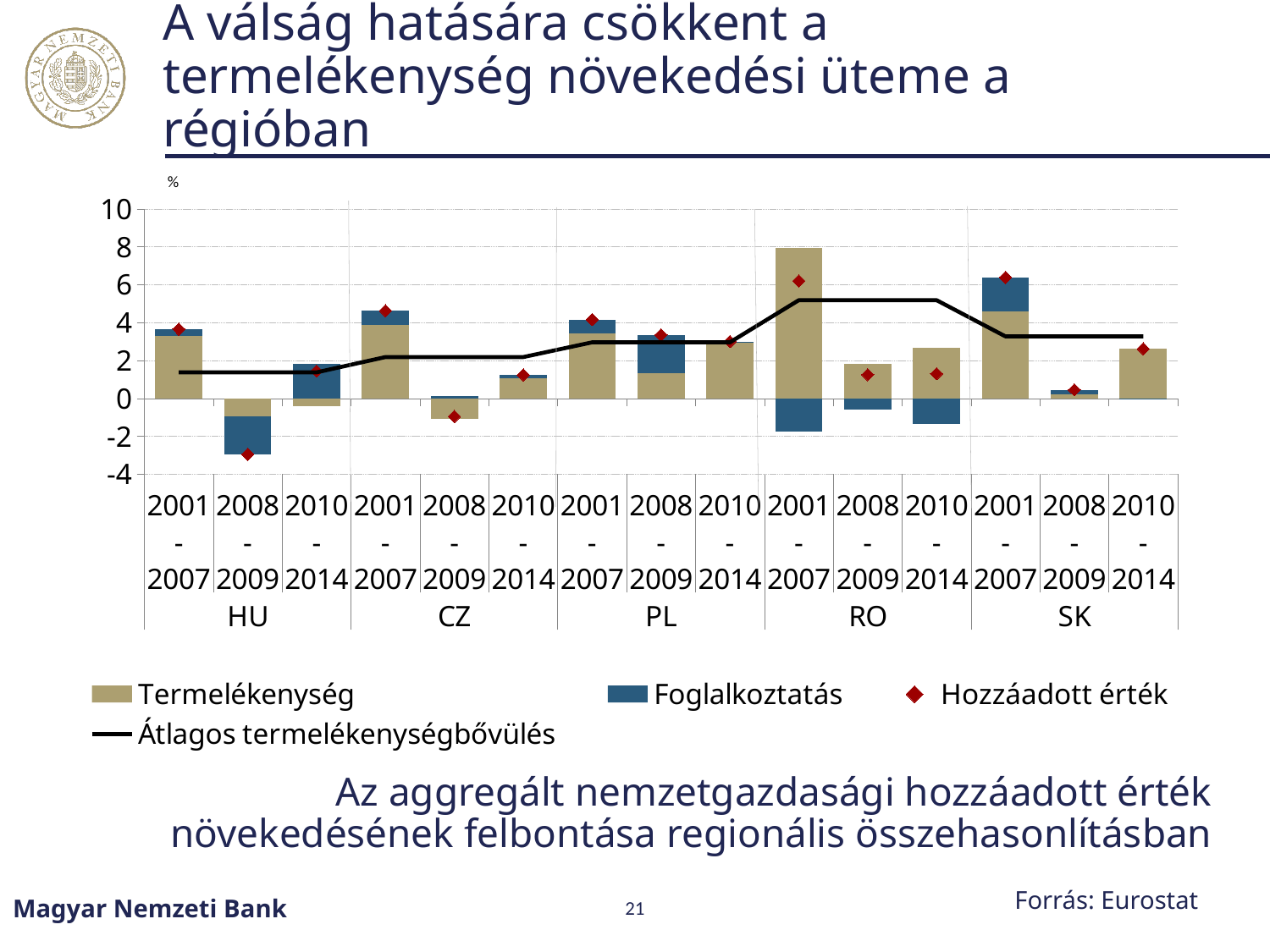
Is the Hozzáadott érték value for HU 2008-2009 greater or less than -2? less How many stacked bars (country-period combinations) are plotted? 15 What kind of chart is shown on the slide? Bar chart (stacked bars with a line and markers) Which legend entry is drawn as a black line? Átlagos termelékenységbővülés Is the Termelékenység value for RO 2001-2007 greater or less than 6? greater How many countries are shown on the x axis? 5 Which has the larger Hozzáadott érték value for 2001-2007: SK or CZ? SK Which country and period has the highest Termelékenység bar? RO, 2001-2007 What unit is shown at the top of the y axis? % Which country and period has the lowest Hozzáadott érték marker? HU, 2008-2009 How many series does the legend list? 4 Does the Átlagos termelékenységbővülés line rise or fall from RO to SK? falls